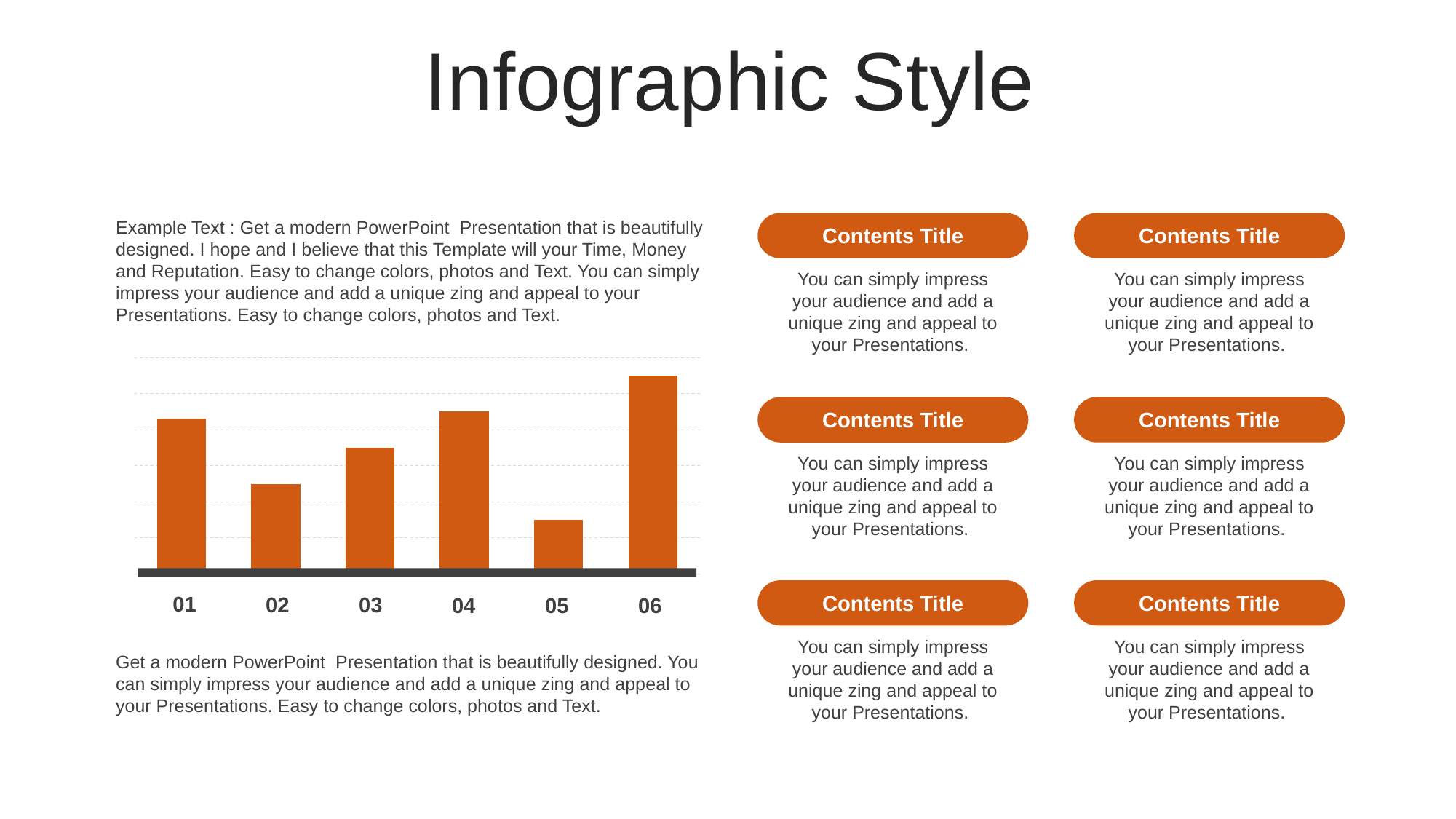
Which category has the highest bar on the chart? 06 How many categories are plotted on the bar chart? 6 Which bar is taller, 02 or 05? 02 What colour are the bars in the chart? orange Which bar is taller, 03 or 02? 03 Which bar is taller, 06 or 04? 06 What are the category labels along the x axis of the chart? 01, 02, 03, 04, 05, 06 What kind of chart is shown on the slide? bar chart Which category has the lowest bar on the chart? 05